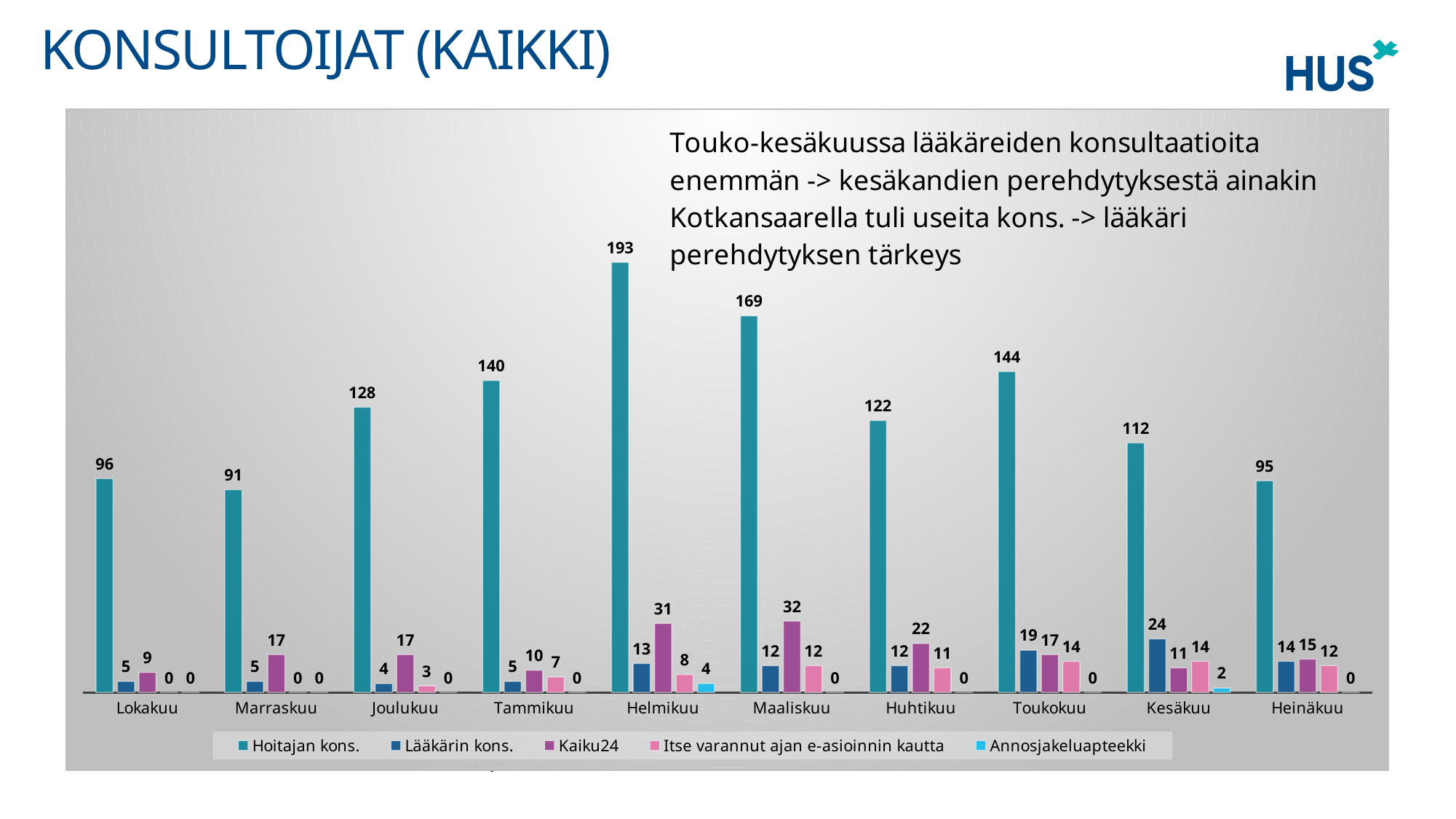
What is the value of Hoitajan kons. for Helmikuu? 193 What is the total of all five series for Kesäkuu? 163 Which is larger: Lääkärin kons. for Toukokuu or Lääkärin kons. for Heinäkuu? Toukokuu How many series does the legend list? 5 Which month has the highest value for Hoitajan kons.? Helmikuu How many months are shown on the x axis? 10 What is the value of Kaiku24 for Maaliskuu? 32 What kind of chart is shown on the slide? Bar chart What is the value of Lääkärin kons. for Kesäkuu? 24 What is the value of Itse varannut ajan e-asioinnin kautta for Toukokuu? 14 What is the difference between the Hoitajan kons. values for Helmikuu and Maaliskuu? 24 Which month has the lowest value for Hoitajan kons.? Marraskuu